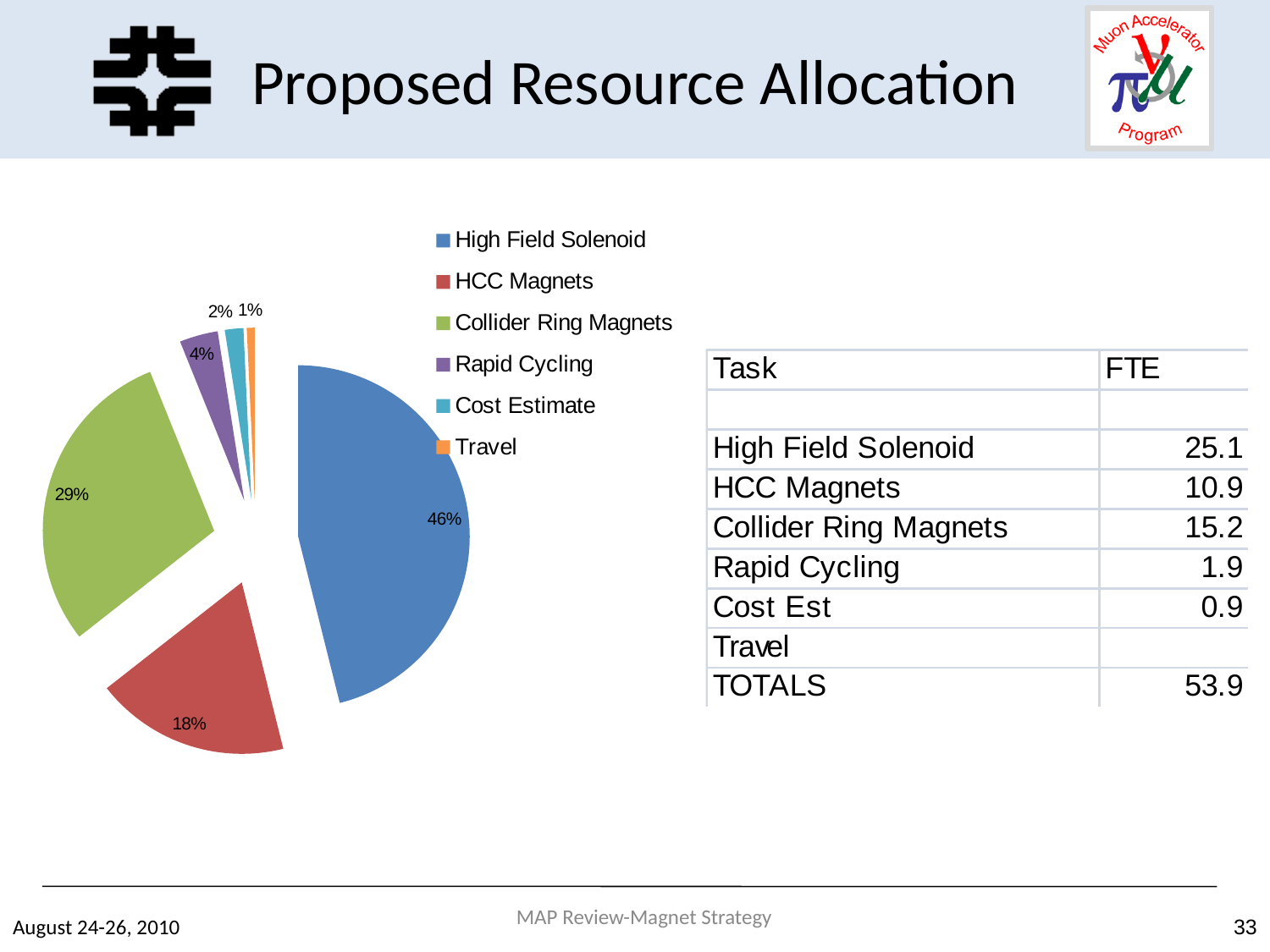
What colour is the High Field Solenoid slice in the pie chart? blue Which category has the smallest slice of the pie? Travel How many categories does the legend of the pie chart list? 6 What share of the pie does Cost Estimate take? 2% What share of the pie does High Field Solenoid take? 46% Which slice is larger, HCC Magnets or Collider Ring Magnets? Collider Ring Magnets Which category has the largest slice of the pie? High Field Solenoid What kind of chart is shown on the slide? pie chart What share of the pie does Rapid Cycling take? 4% What is the difference in percentage points between the High Field Solenoid slice and the Collider Ring Magnets slice? 17%